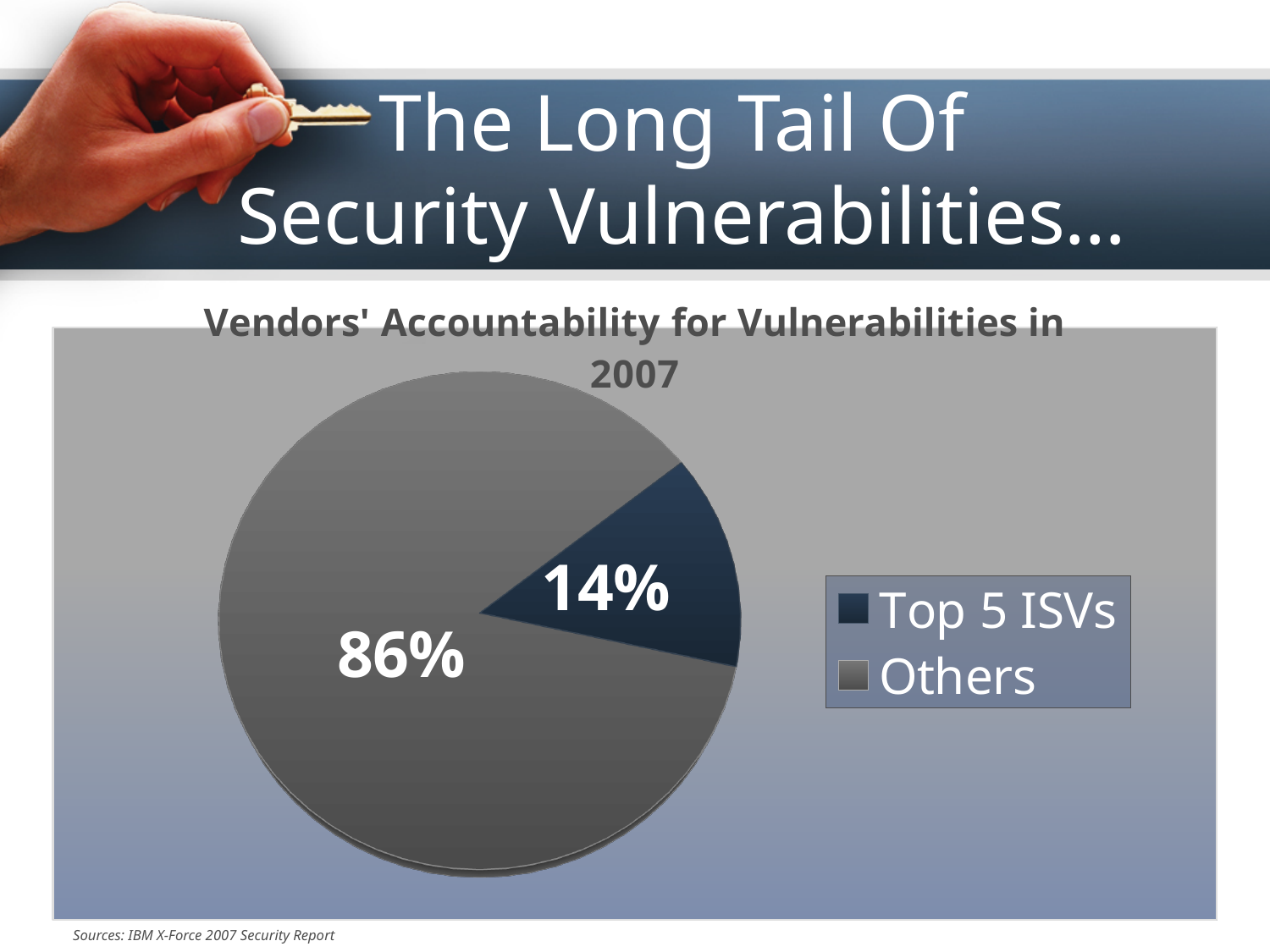
Which category has the largest slice of the pie? Others What is the difference in percentage points between Others and Top 5 ISVs? 72 Which is larger, the share for Top 5 ISVs or the share for Others? Others What is the title of the chart? Vendors' Accountability for Vulnerabilities in 2007 What type of chart is shown on the slide? pie chart What share of vulnerabilities is attributed to Others? 86% What is the total of the two slices shown in the pie chart? 100% What share of vulnerabilities is attributed to Top 5 ISVs? 14% Which category is shown in dark blue in the legend? Top 5 ISVs How many entries does the legend list? 2 Which category has the smallest slice of the pie? Top 5 ISVs How many categories does the pie chart have? 2